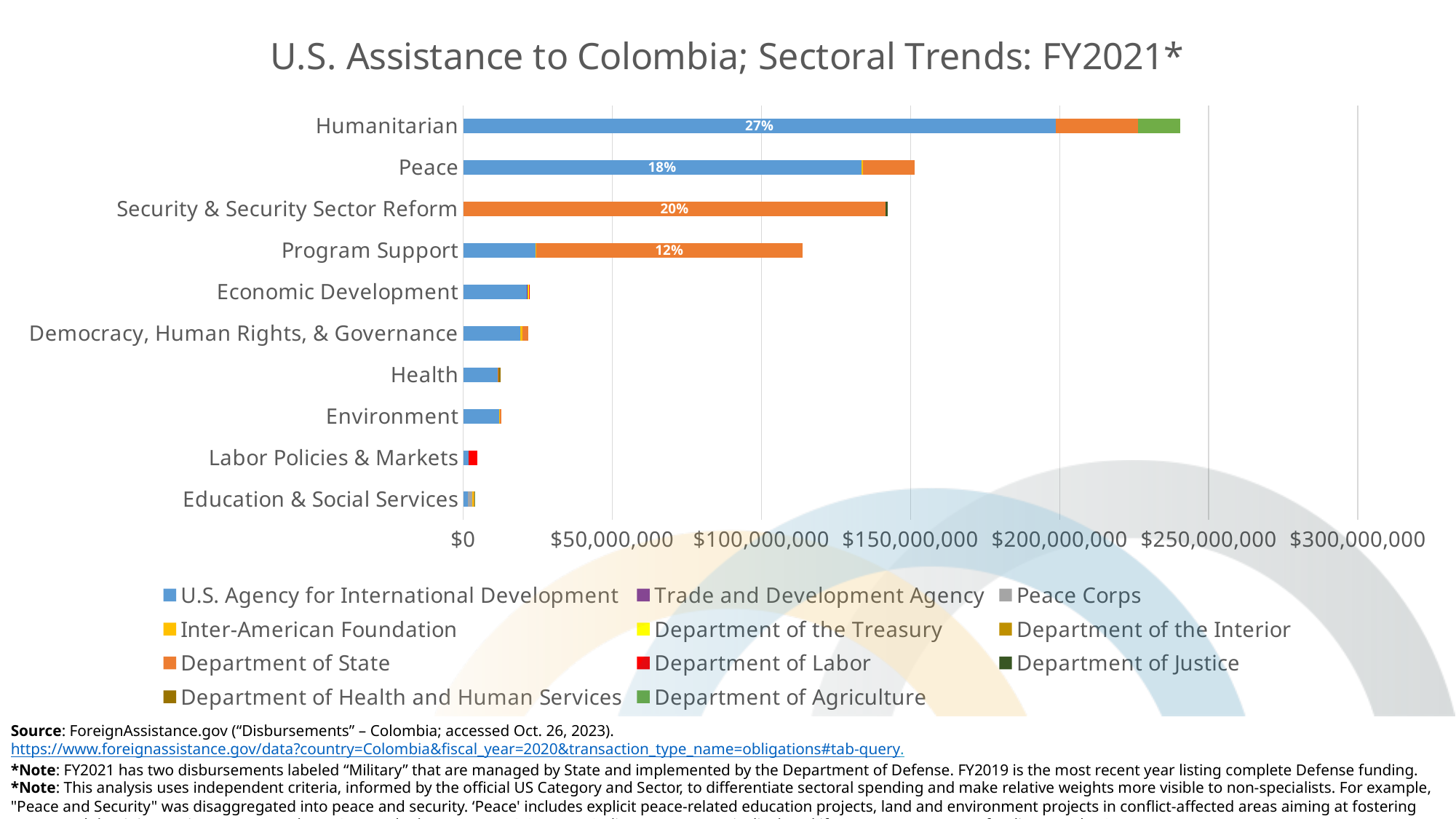
How many sector categories are plotted on the chart? 10 How many agencies does the legend list? 11 What percentage label is printed on the Program Support bar? 12% What is the title of the chart? U.S. Assistance to Colombia; Sectoral Trends: FY2021* Which sector has the largest total bar? Humanitarian What percentage label is printed on the Security & Security Sector Reform bar? 20% Which has the larger total bar, Security & Security Sector Reform or Program Support? Security & Security Sector Reform Is the total value for Program Support greater or less than $100,000,000? greater What kind of chart is shown on the slide? bar chart What is the difference in percentage points between the Humanitarian label (27%) and the Peace label (18%)? 9 percentage points Is the total value for Humanitarian greater or less than $200,000,000? greater What percentage label is printed on the Humanitarian bar? 27%